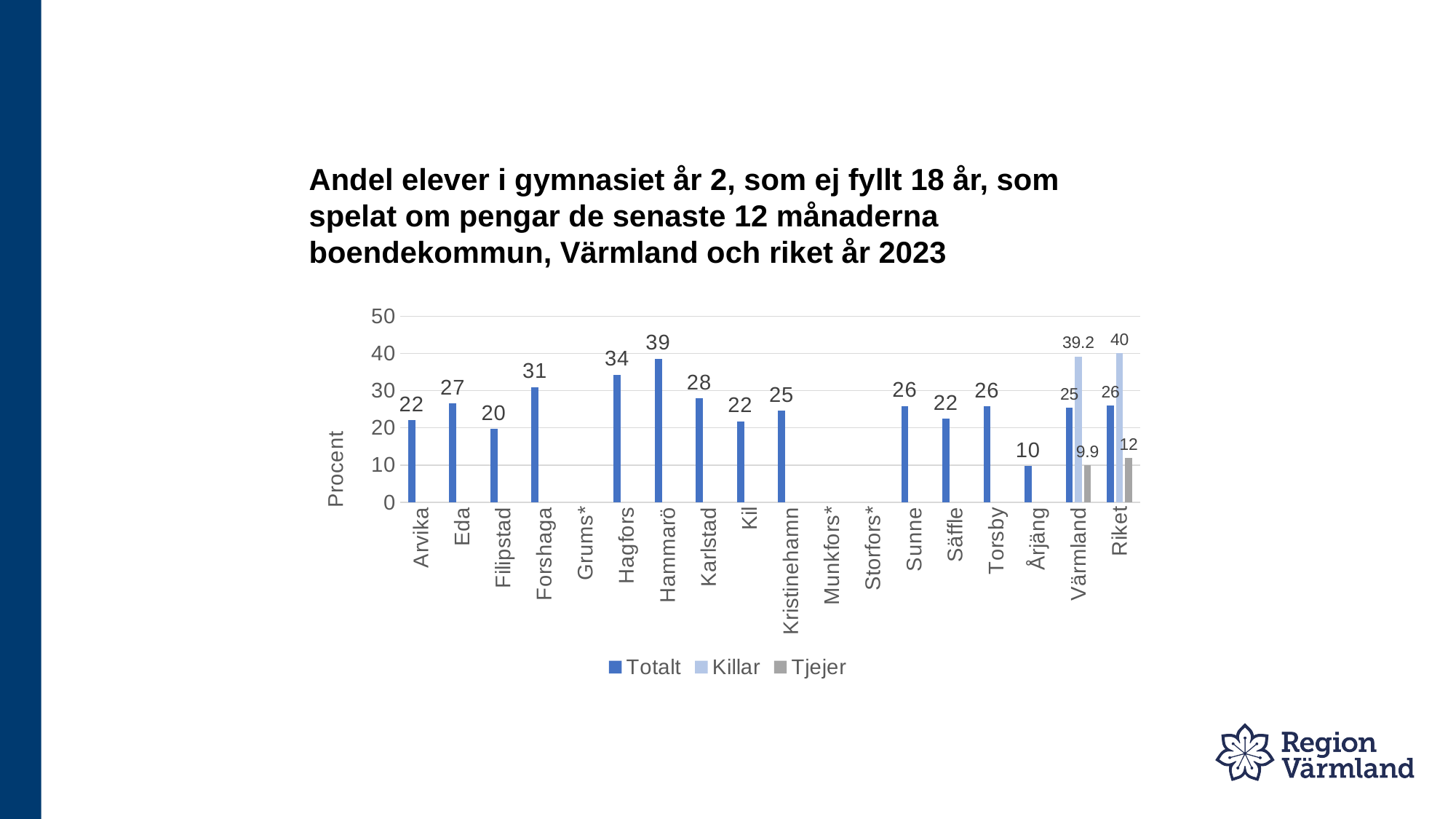
What is the difference between the Killar and Tjejer values for Riket? 28 What is the Killar value for Värmland? 39.2 How many categories are shown on the x axis? 18 How many series does the legend list? 3 Is the Totalt value for Årjäng greater or less than 20? less Which municipality has the lowest Totalt value among those with a plotted bar? Årjäng What is the Totalt value for Hammarö? 39 Which has a higher Totalt value, Hagfors or Forshaga? Hagfors Which municipality has the highest Totalt value? Hammarö What is the difference between the Totalt values for Hammarö and Årjäng? 29 What is the Tjejer value for Riket? 12 What kind of chart is shown on the slide? Bar chart